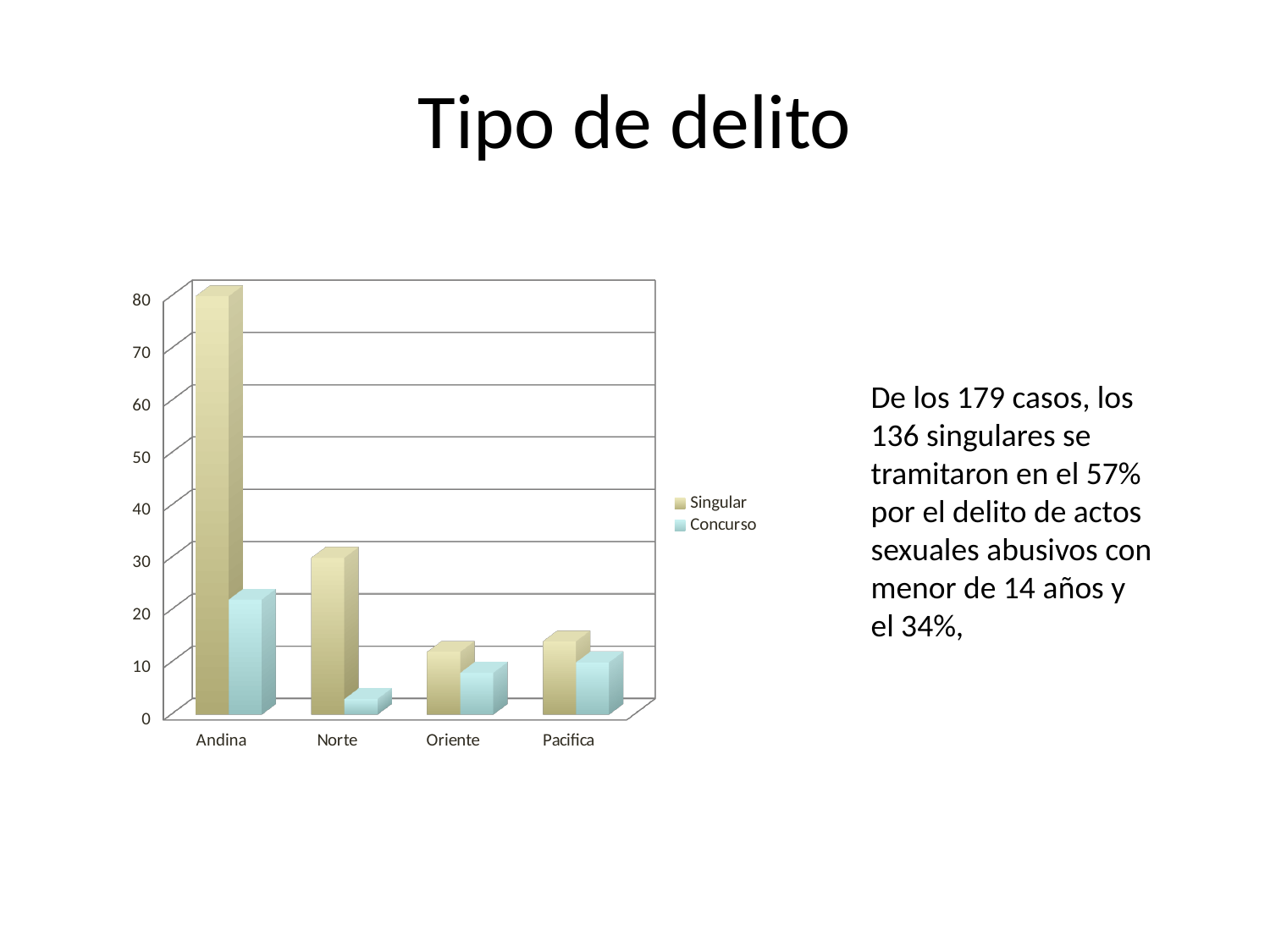
Is the Singular value for Norte greater or less than 20? greater How many series does the chart legend list? 2 For Andina, which is larger: the Singular value or the Concurso value? Singular Which category has the highest Singular value? Andina Is the Singular value for Pacifica greater or less than 20? less What are the two series named in the chart legend? Singular and Concurso What kind of chart is shown on the slide? bar chart Which category has the highest Concurso value? Andina Is the Singular value for Andina greater or less than 70? greater Which category has the lowest Concurso value? Norte How many categories are shown on the x axis of the chart? 4